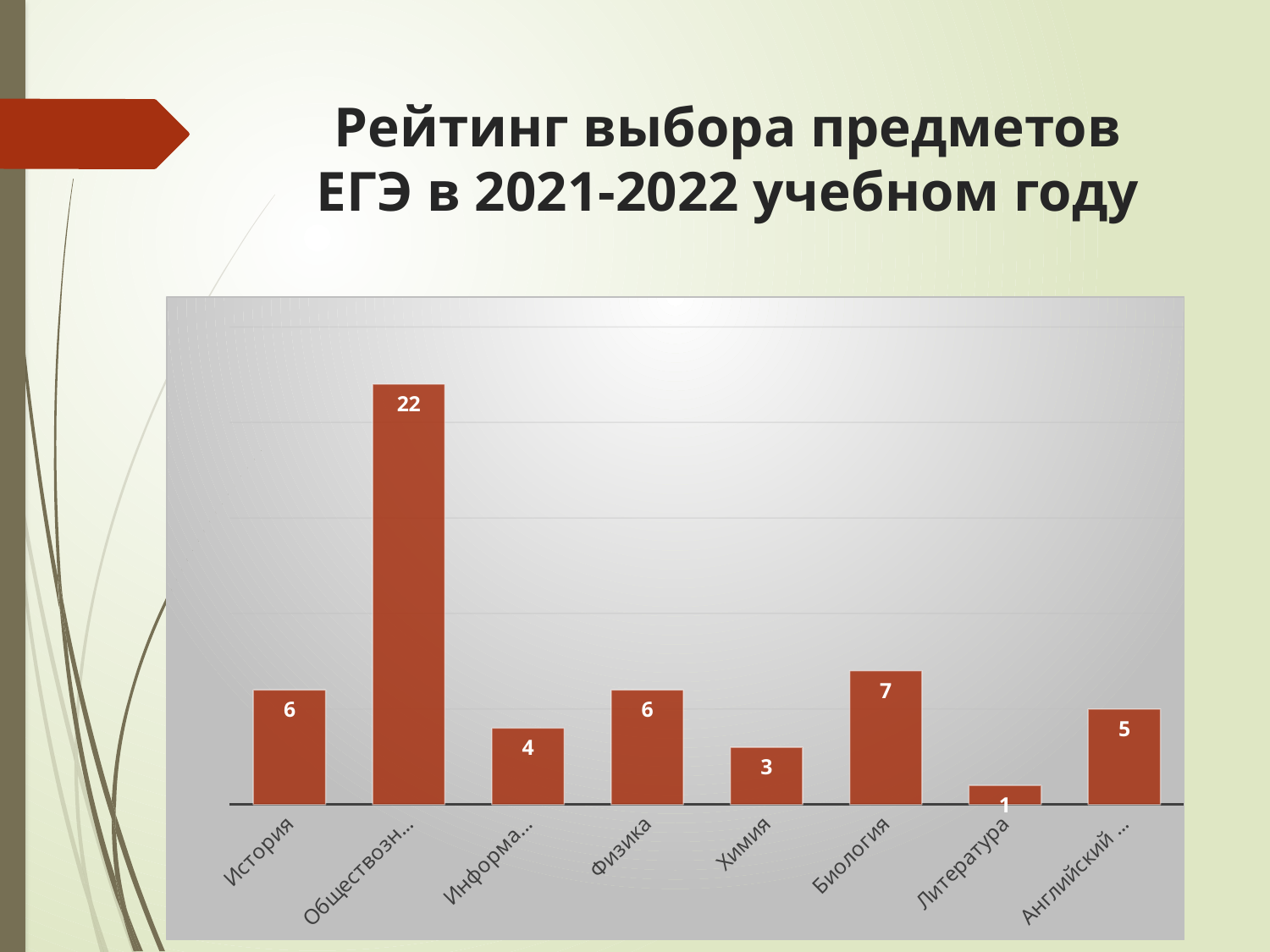
Which category has the lowest value? Литература What is the difference between the values for Биология and Химия? 4 What is the value for Литература? 1 What is the title of the slide? Рейтинг выбора предметов ЕГЭ в 2021-2022 учебном году Which category has the highest value? Обществозн... Which is larger, the value for Физика or the value for Химия? Физика How many categories are shown in the chart? 8 What is the value for История? 6 What is the value of the second bar from the left (Обществозн...)? 22 What is the value for Химия? 3 What kind of chart is shown on the slide? Bar chart What is the value for Биология? 7